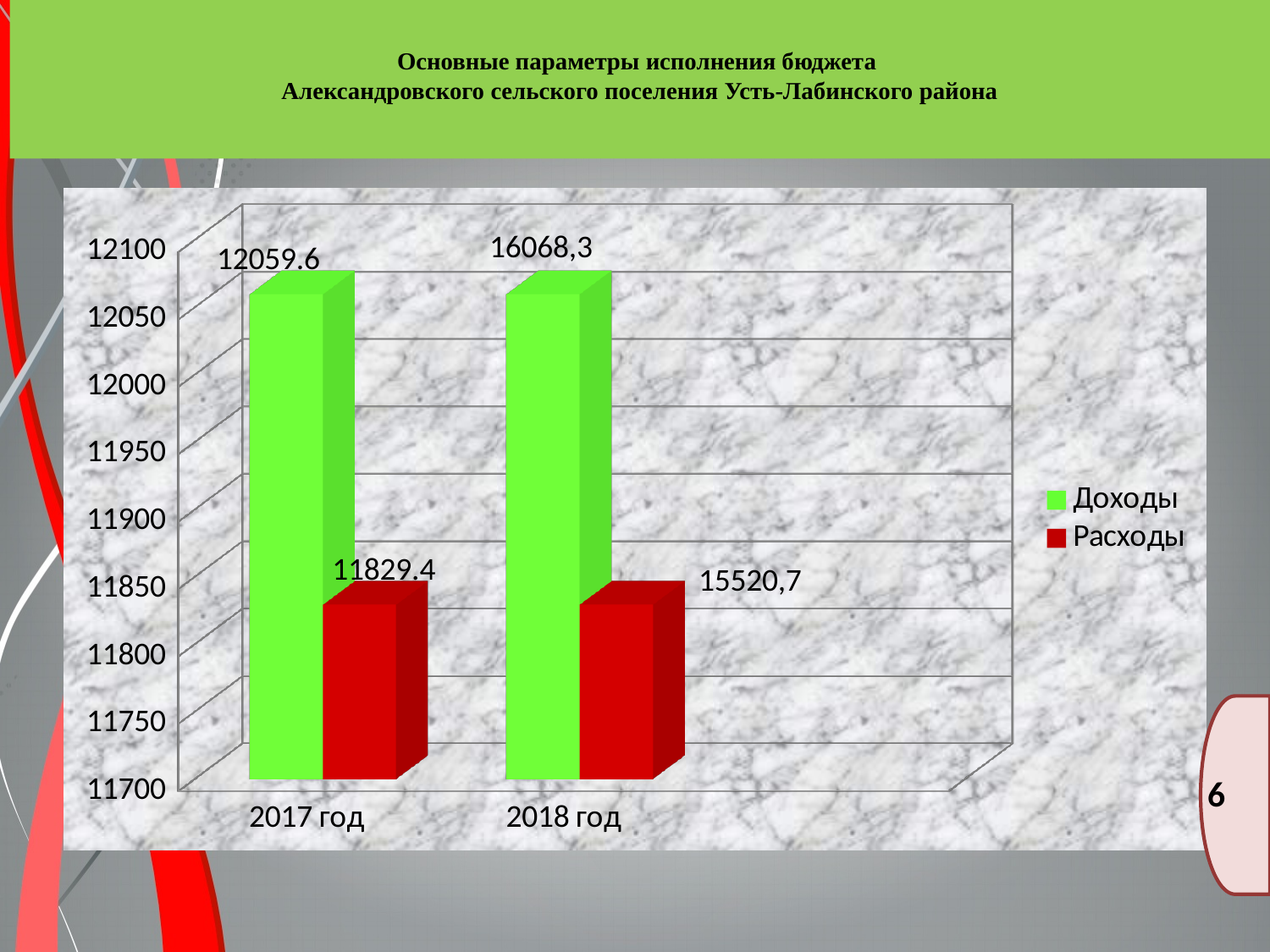
What is the value of Расходы for 2017 год? 11829.4 How many series does the legend list? 2 What is the value of Доходы for 2017 год? 12059.6 What is the difference between Доходы and Расходы in 2017 год? 230.2 In 2018 год, which is larger: Доходы or Расходы? Доходы Which series is shown in green? Доходы What kind of chart is shown on the slide? Bar chart What is the value of Расходы for 2018 год? 15520,7 What is the value of Доходы for 2018 год? 16068,3 What are the two entries in the legend? Доходы and Расходы In 2017 год, which is larger: Доходы or Расходы? Доходы How many categories (years) are shown on the x axis? 2